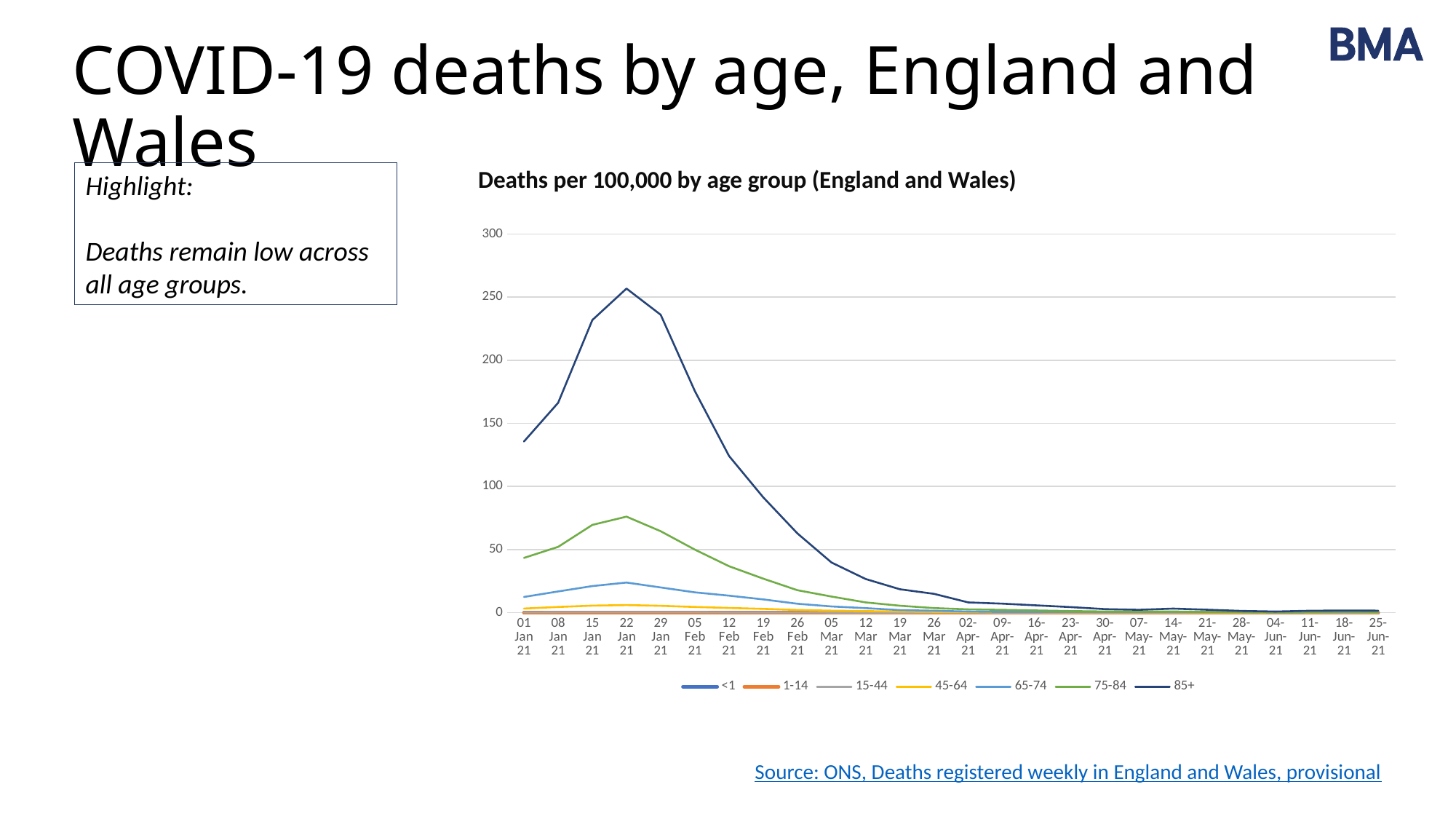
Which age group has the highest deaths per 100,000 throughout the chart? 85+ What kind of chart is shown on the slide? Line chart Which age group has the higher value on 22 Jan 21, 85+ or 75-84? 85+ How many age groups does the legend list? 7 Is the value for the 75-84 age group on 22 Jan 21 greater or less than 50? greater Is the value for the 85+ age group on 22 Jan 21 greater or less than 250? greater On which date does the 85+ line reach its peak? 22 Jan 21 What is the title of the chart? Deaths per 100,000 by age group (England and Wales) How many weekly dates are shown along the x axis? 26 Is the value for the 85+ age group on 05 Mar 21 greater or less than 50? less Does the 85+ line rise or fall from 22 Jan 21 to 25 Jun 21? Fall